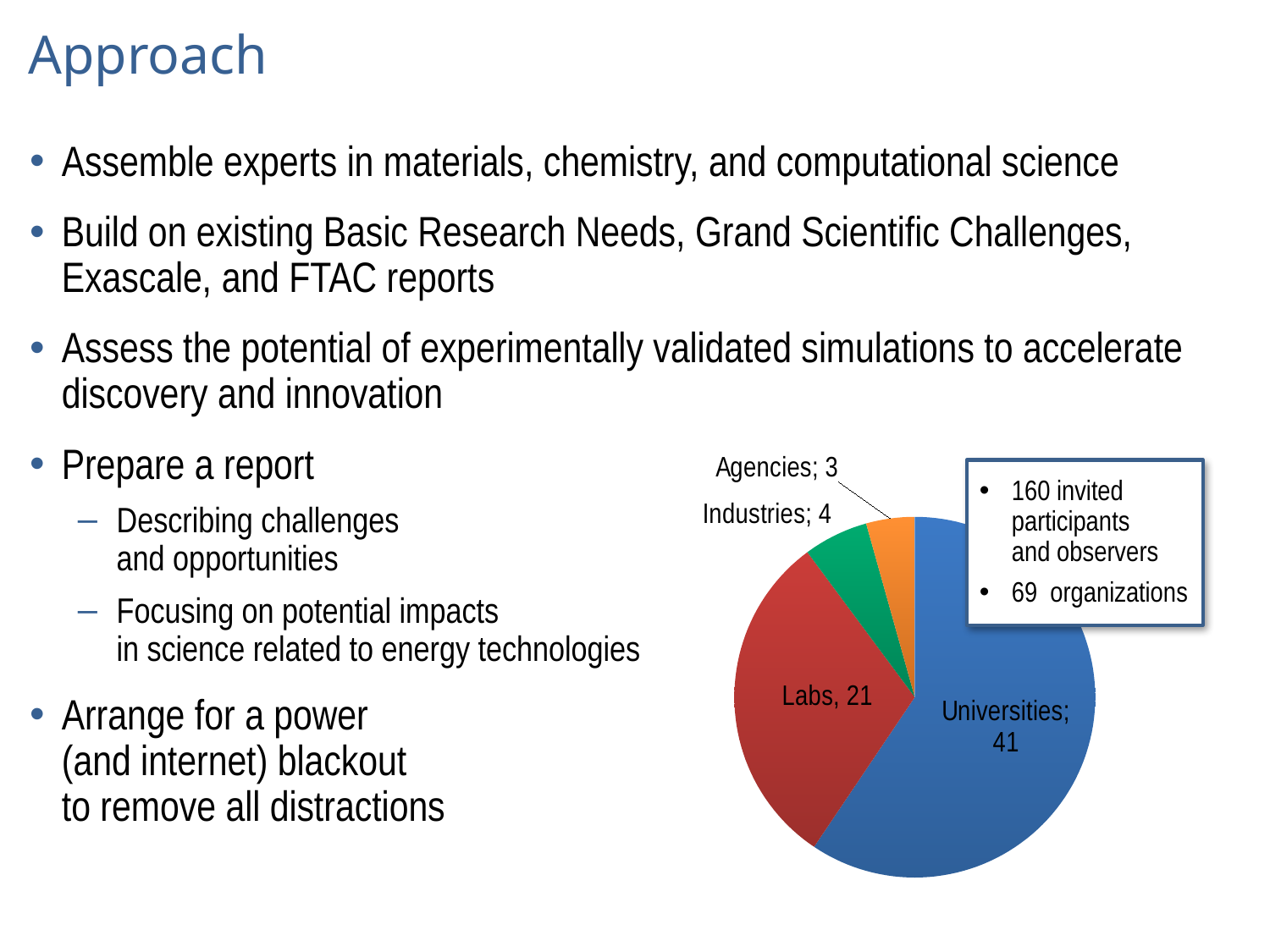
What is the difference between the Universities value and the Labs value in the pie chart? 20 Which category has the smallest slice in the pie chart? Agencies What is the value for Industries in the pie chart? 4 What colour is the Labs slice in the pie chart? red What is the value for Labs in the pie chart? 21 What is the total of all four slices in the pie chart? 69 Which is larger in the pie chart, Industries or Agencies? Industries What is the value for Agencies in the pie chart? 3 What is the value for Universities in the pie chart? 41 Which category has the largest slice in the pie chart? Universities What type of chart is shown on the slide? pie chart How many slices does the pie chart have? 4